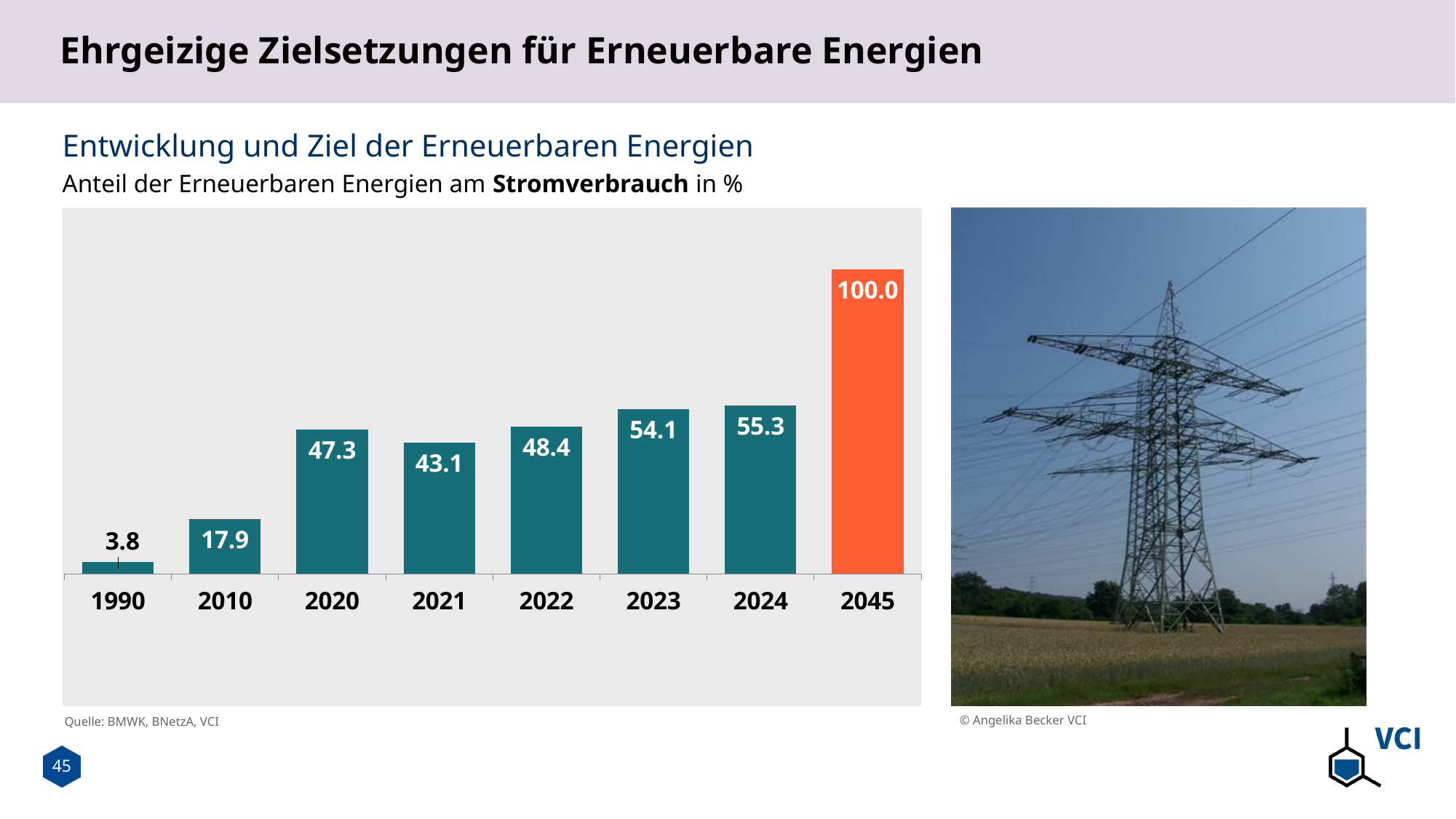
What is the difference between the values for 2045 and 2024? 44.7 Which is larger, the value for 2020 or the value for 2021? 2020 Which bar is shown in a different colour (orange) from the others? 2045 Which year has the highest value? 2045 What is the value for 2020? 47.3 What kind of chart is this? bar chart What is the difference between the values for 2024 and 2023? 1.2 How many years are shown on the x axis? 8 What is the value for 1990? 3.8 Which year has the lowest value? 1990 Do the values generally rise or fall from 1990 to 2045? rise What is the value for 2024? 55.3